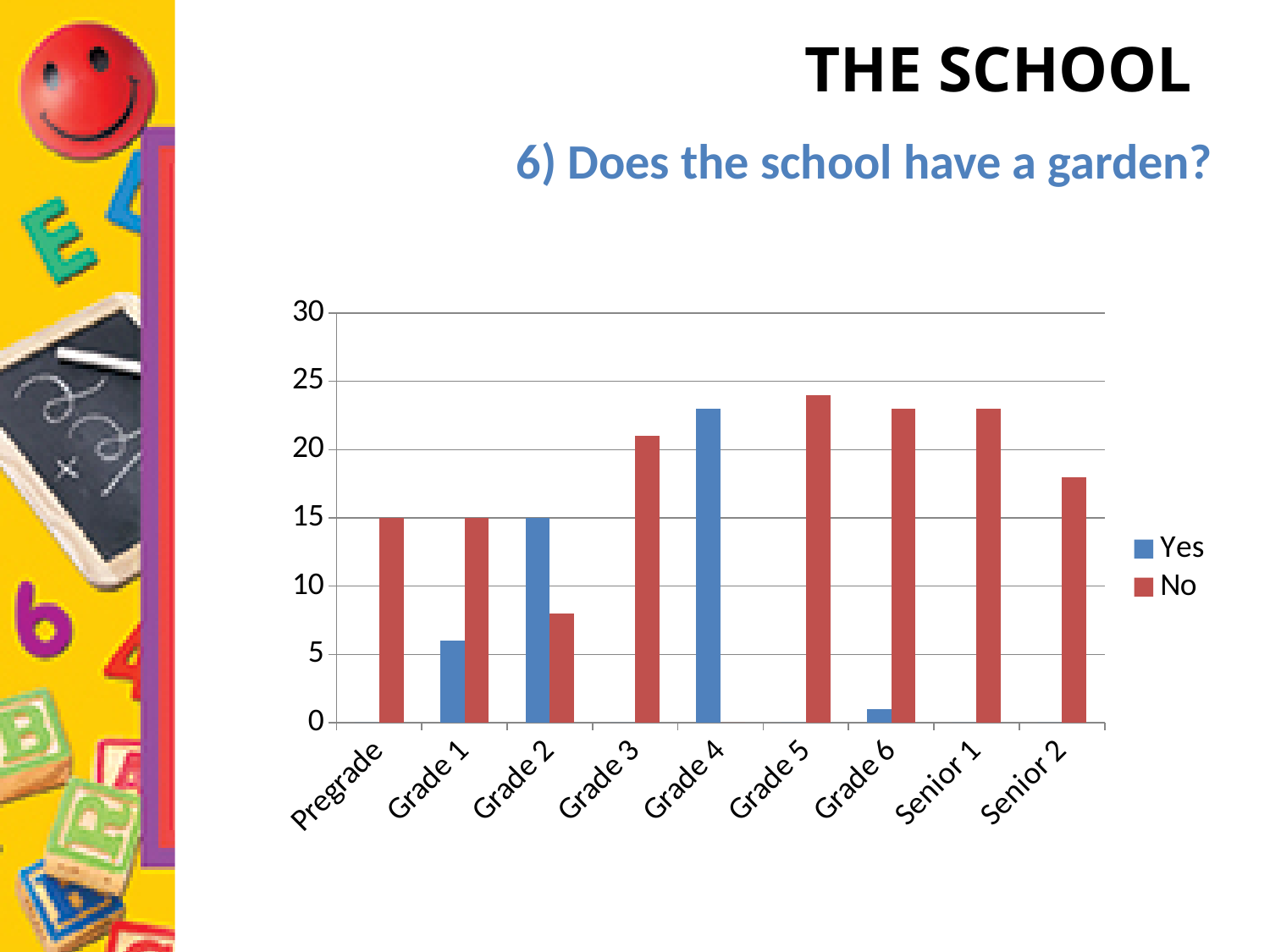
How many series does the legend list? 2 Is the No value for Grade 5 greater or less than 20? greater Which category has the lowest value in the No series? Grade 4 For Grade 1, which is larger, the Yes value or the No value? No For Grade 2, which is larger, the Yes value or the No value? Yes How many grade categories are shown on the x axis? 9 What is the value of the No series for Pregrade? 15 What question does the chart's heading ask? Does the school have a garden? What kind of chart is shown on the slide? bar chart Which category has the highest value in the Yes series? Grade 4 Is the Yes value for Grade 6 greater or less than 5? less What is the value of the Yes series for Grade 2? 15